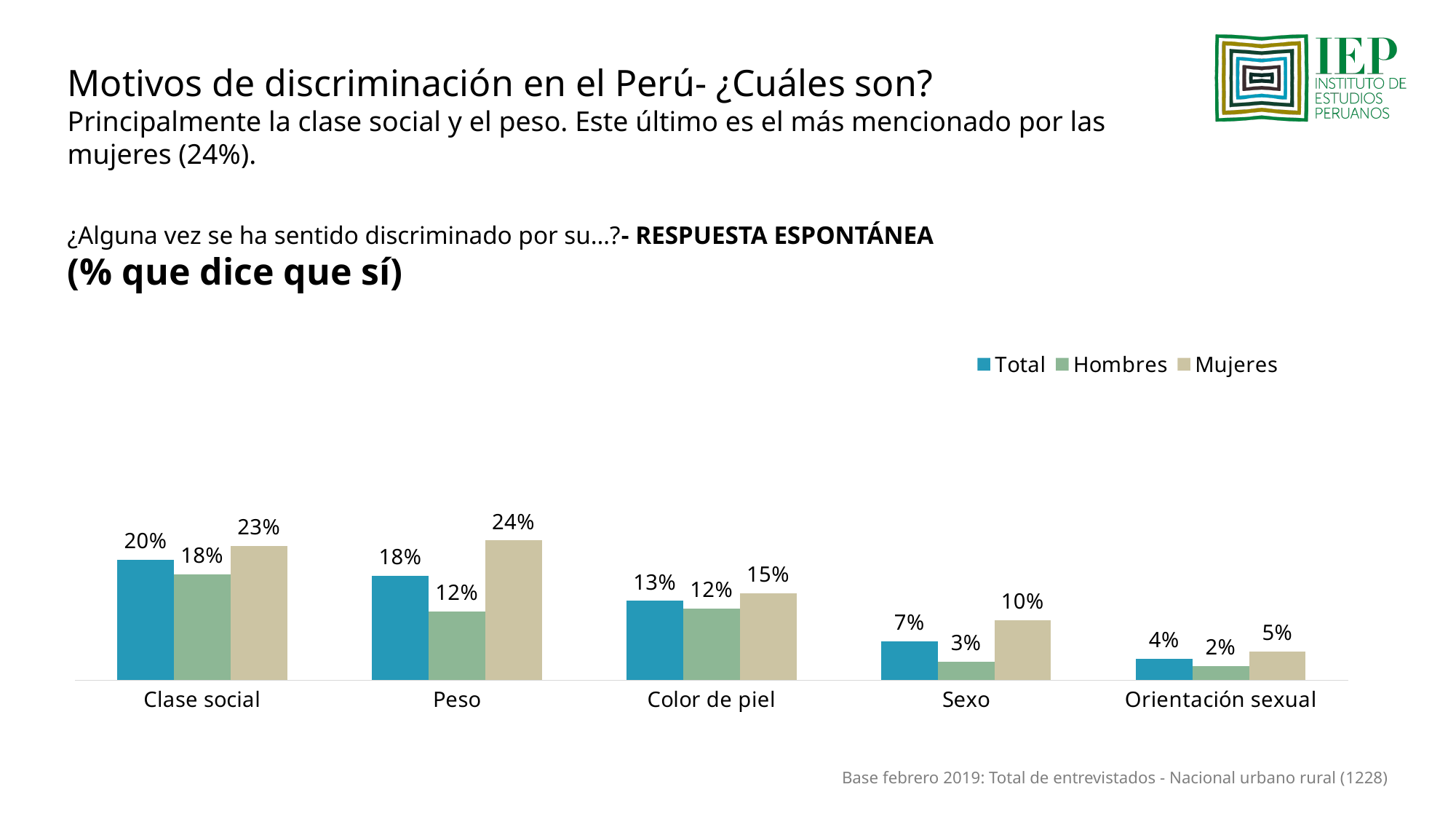
What is the Total value for Orientación sexual? 4% What is the difference between the Mujeres and Hombres values for Peso? 12% What is the Total value for Clase social? 20% How many categories are shown on the x axis? 5 What is the Mujeres value for Peso? 24% Which category has the lowest Hombres value? Orientación sexual What is the Hombres value for Sexo? 3% Which category has the highest Mujeres value? Peso How many series does the legend list? 3 What kind of chart is shown on the slide? Bar chart Which is larger for Color de piel, the Total value or the Mujeres value? Mujeres Do the Total values rise or fall from Clase social to Orientación sexual? Fall